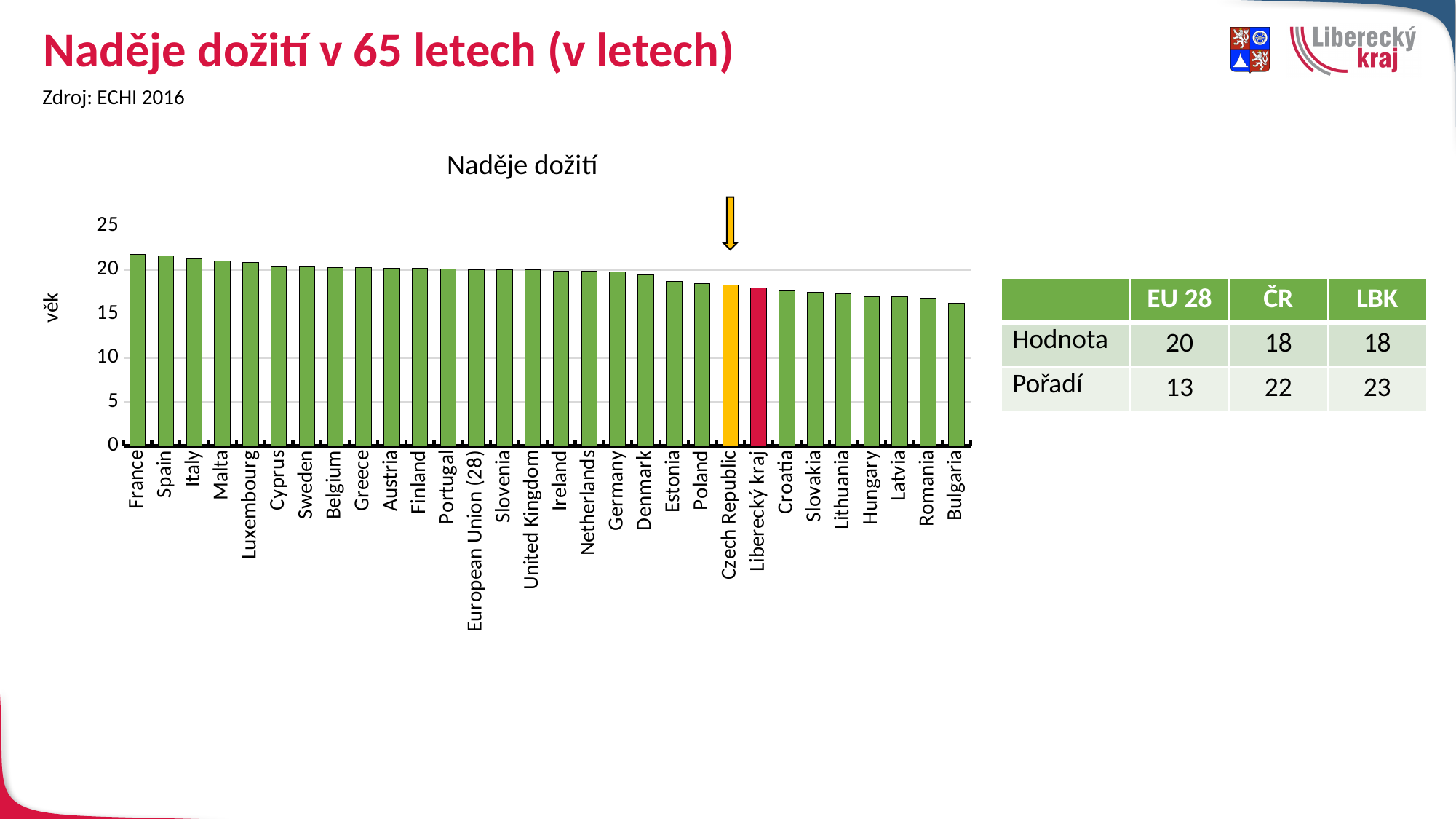
What kind of chart is shown on the slide? bar chart Which country has the highest value in the chart? France Do the values rise or fall moving from left to right along the x axis? fall Is the value for Hungary greater or less than 15? greater How many bars (categories) are plotted in the chart? 30 Which has the larger value, Spain or Romania? Spain Is the value for Bulgaria greater or less than 20? less What colour is the bar for Liberecký kraj? red Is the value for France greater or less than 20? greater What is the title of the chart? Naděje dožití Which country has the lowest value in the chart? Bulgaria